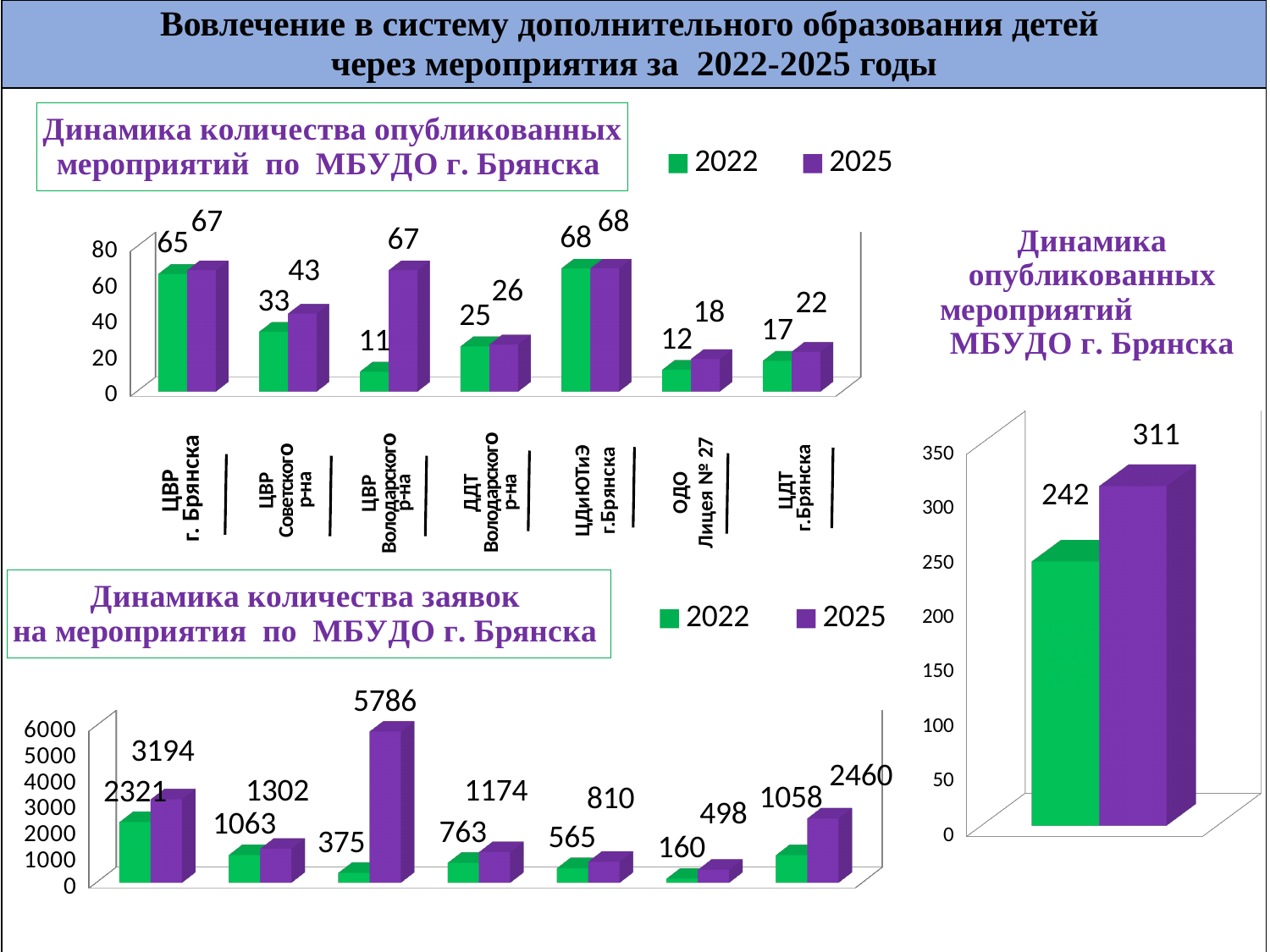
On the chart 'Динамика количества заявок на мероприятия по МБУДО г. Брянска', what is the 2022 value for the first category? 2321 What type of chart is 'Динамика опубликованных мероприятий МБУДО г. Брянска' on the right of the slide? Bar chart On the chart 'Динамика количества опубликованных мероприятий по МБУДО г. Брянска', what is the 2022 value for ОДО Лицея № 27? 12 On the chart 'Динамика опубликованных мероприятий МБУДО г. Брянска' on the right, what is the difference between the 2025 and 2022 values? 69 On the chart 'Динамика количества опубликованных мероприятий по МБУДО г. Брянска', how many series does the legend list? 2 On the chart 'Динамика количества опубликованных мероприятий по МБУДО г. Брянска', which category has the lowest 2022 value? ЦВР Володарского р-на On the chart 'Динамика количества заявок на мероприятия по МБУДО г. Брянска', what is the difference between the 2025 and 2022 values for the last category (2460 and 1058)? 1402 On the chart 'Динамика количества опубликованных мероприятий по МБУДО г. Брянска', how many categories are shown? 7 On the chart 'Динамика количества опубликованных мероприятий по МБУДО г. Брянска', what is the difference between the 2025 and 2022 values for ЦВР Советского р-на? 10 On the chart 'Динамика опубликованных мероприятий МБУДО г. Брянска' on the right, is the 2022 value greater or less than 250? less On the chart 'Динамика количества опубликованных мероприятий по МБУДО г. Брянска', what is the 2025 value for ЦВР Володарского р-на? 67 On the chart 'Динамика количества заявок на мероприятия по МБУДО г. Брянска', what is the highest 2025 value shown? 5786